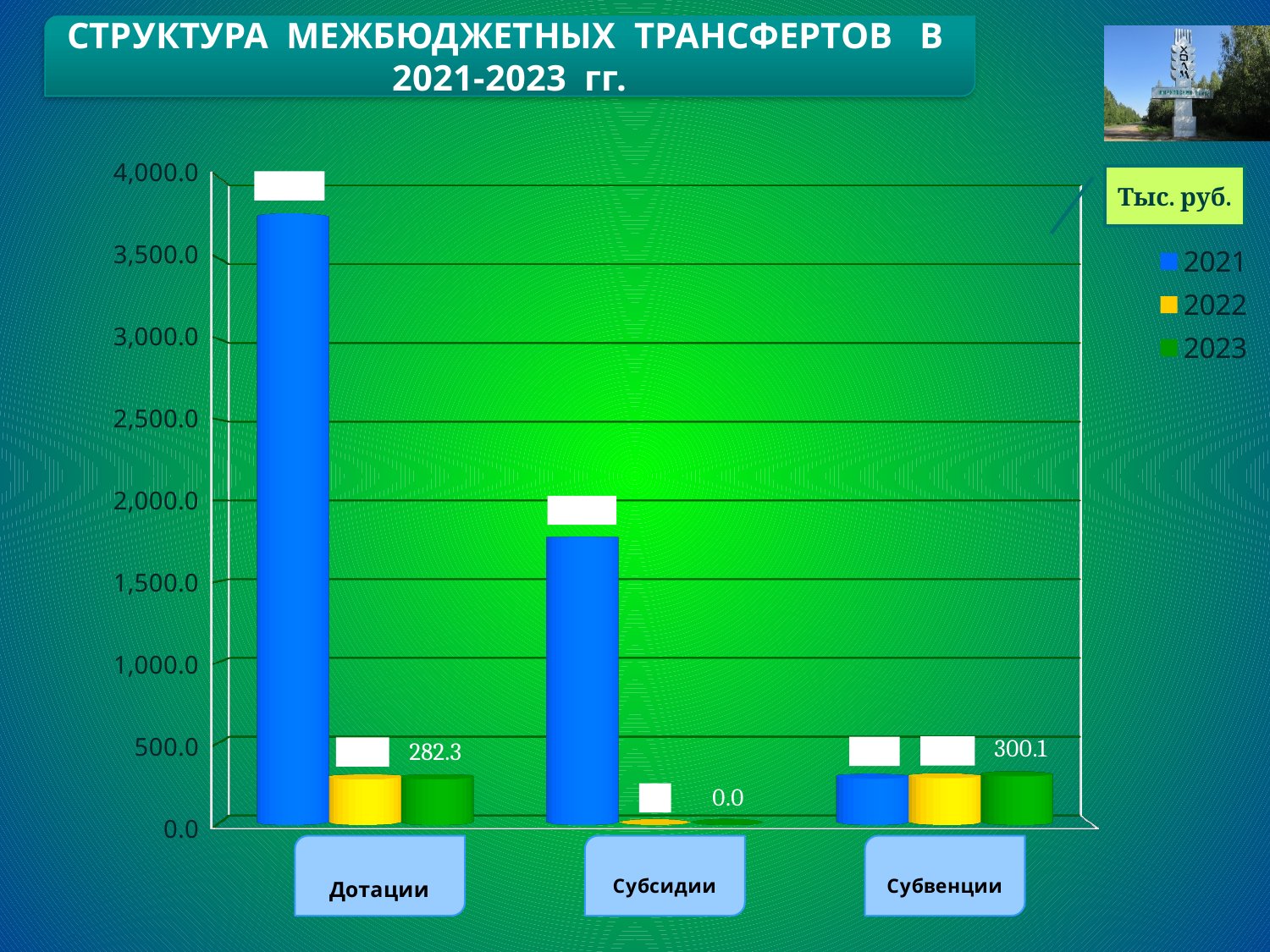
What is the value for Дотации in 2023? 282.3 How many series does the legend list? 3 What kind of chart is shown on the slide? bar chart How many categories are shown on the x axis? 3 Is the value for Дотации in 2021 greater or less than 3,500.0? greater Which is larger for 2021: Дотации or Субсидии? Дотации What is the value for Субсидии in 2023? 0.0 What is the difference between the 2023 values for Субвенции and Дотации? 17.8 Is the value for Субсидии in 2021 greater or less than 2,000.0? less What is the value for Субвенции in 2023? 300.1 Which category has the lowest value for 2023? Субсидии Which category has the highest value for 2021? Дотации